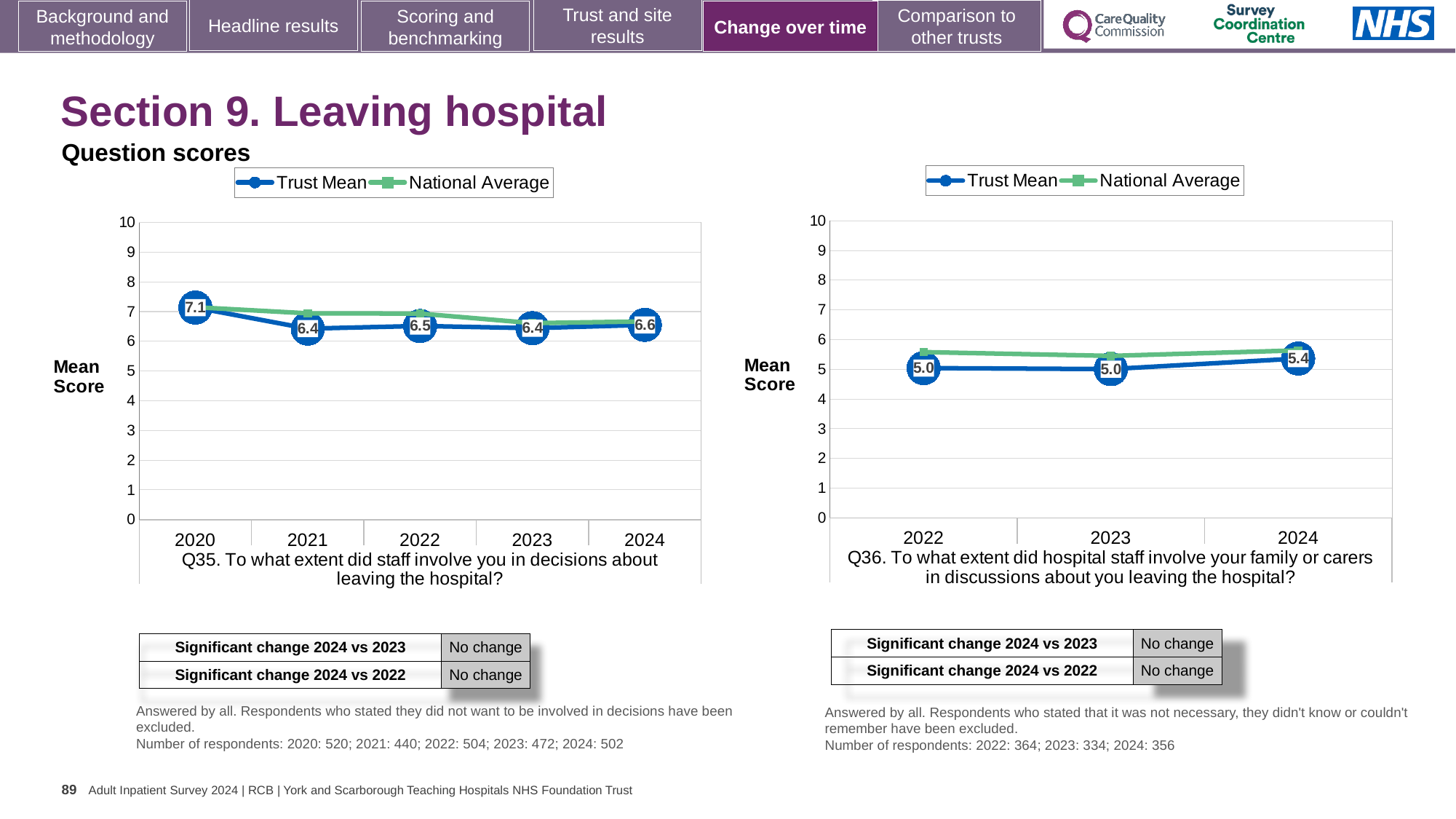
On the Q36 chart (right), what is the Trust Mean score for 2024? 5.4 On the Q35 chart (left), how many years are plotted on the x axis? 5 On the Q36 chart (right), how many series does the legend list? 2 On the Q36 chart (right), which year has the highest Trust Mean score? 2024 On the Q36 chart (right), what is the Trust Mean score for 2022? 5.0 On the Q36 chart (right), what is the difference between the Trust Mean scores for 2024 and 2023? 0.4 On the Q35 chart (left), which year has the highest Trust Mean score? 2020 On the Q35 chart (left), is the National Average for 2020 greater or less than 6? greater On the Q35 chart (left), what is the Trust Mean score for 2020? 7.1 On the Q35 chart (left), what is the difference between the Trust Mean scores for 2020 and 2021? 0.7 On the Q35 chart (left), what is the Trust Mean score for 2024? 6.6 What kind of chart is the Q36 chart (right)? Line chart